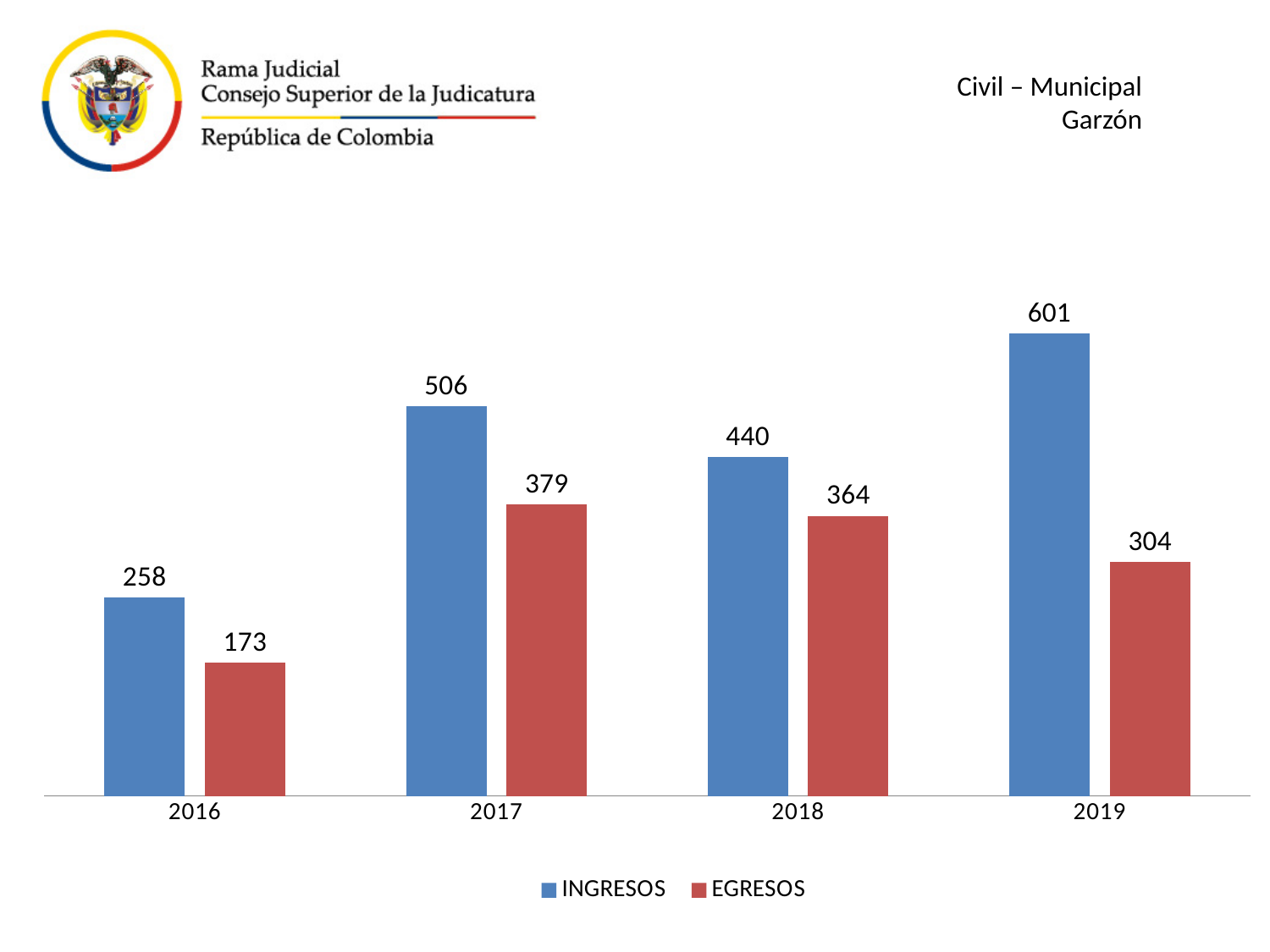
How many series does the legend list? 2 Which year has the lowest EGRESOS value? 2016 What is the INGRESOS value for 2016? 258 How many years are shown on the x axis? 4 Which year has the highest INGRESOS value? 2019 Which colour represents EGRESOS in the chart? Red What is the EGRESOS value for 2018? 364 What is the EGRESOS value for 2019? 304 What kind of chart is shown on the slide? Bar chart Which is larger, EGRESOS in 2017 or EGRESOS in 2018? EGRESOS in 2017 What is the difference between INGRESOS in 2017 and INGRESOS in 2018? 66 What is the difference between INGRESOS and EGRESOS in 2019? 297